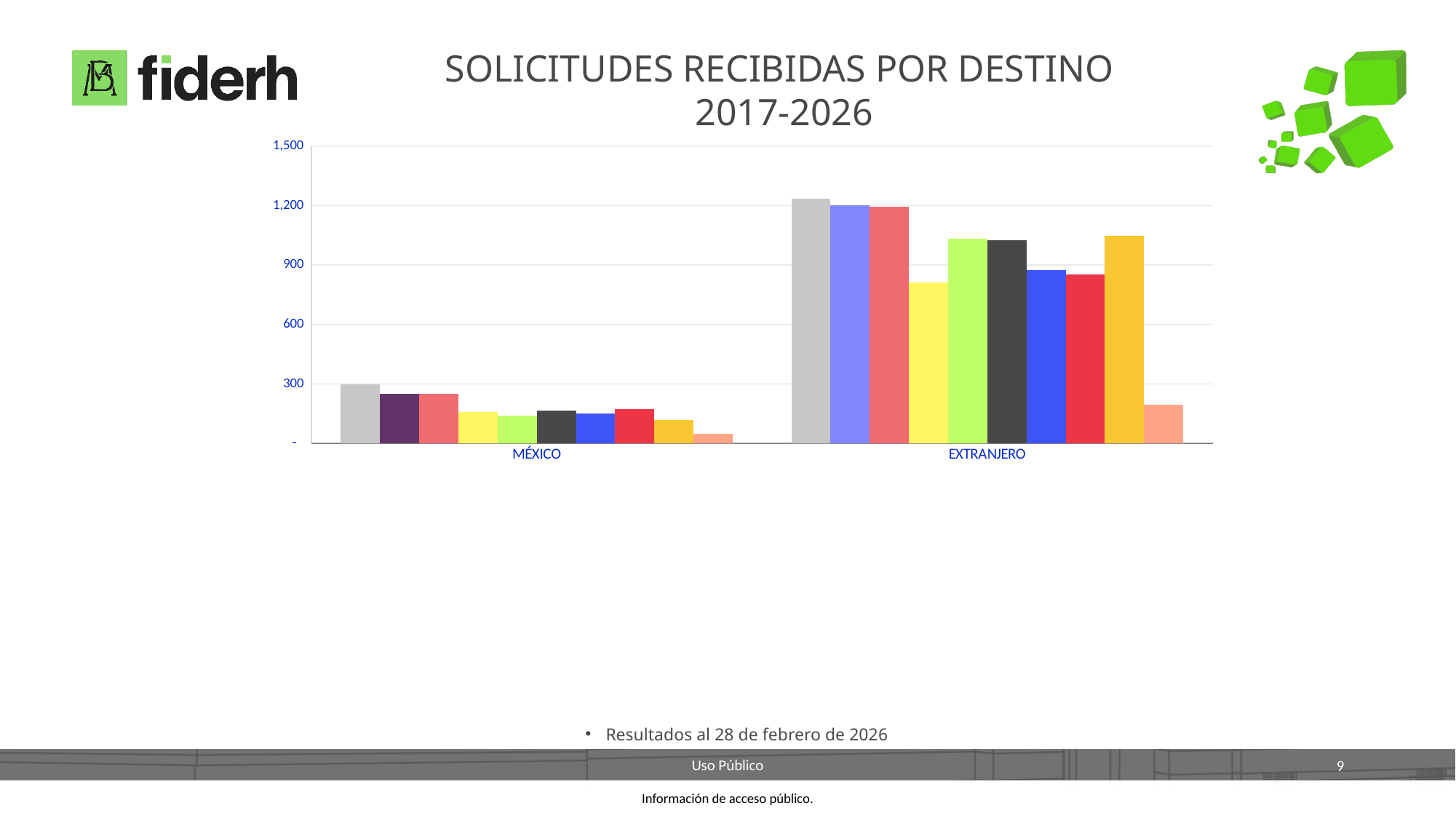
Is the tallest bar for MÉXICO greater or less than 600? less Is the shortest bar for EXTRANJERO greater or less than 300? less How many categories are shown on the x axis? 2 What is the title of the chart? SOLICITUDES RECIBIDAS POR DESTINO 2017-2026 What is the highest value shown on the vertical axis? 1,500 How many bars are plotted for the MÉXICO category? 10 Is the first (grey) bar for MÉXICO greater or less than 600? less Which category has the taller bars, MÉXICO or EXTRANJERO? EXTRANJERO What kind of chart is shown on the slide? Bar chart